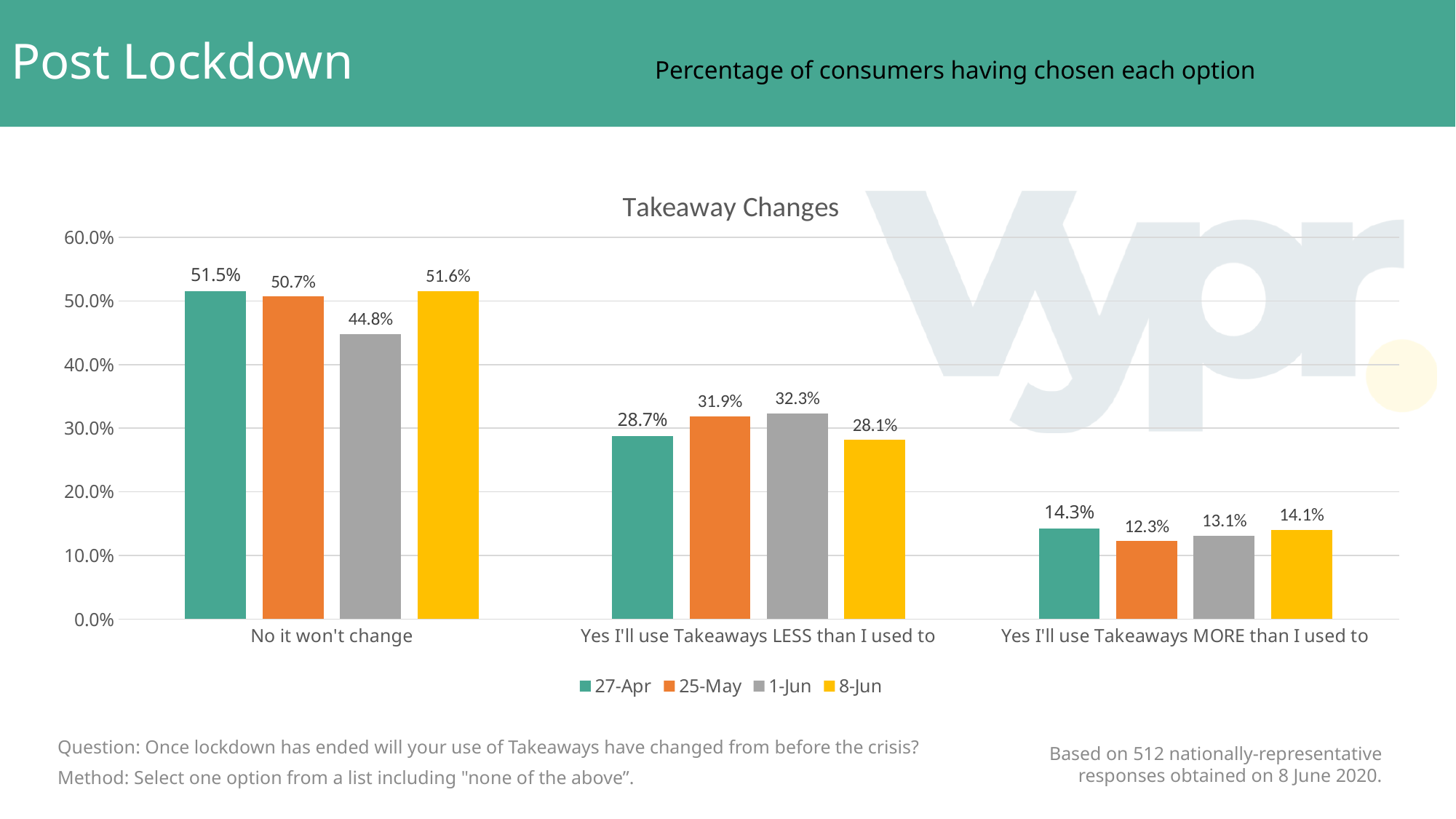
What is the value for 25-May in the 'Yes I'll use Takeaways MORE than I used to' category? 12.3% Which series has the lowest value in the 'No it won't change' category? 1-Jun What kind of chart is shown on the slide? bar chart Which series has the highest value in the 'Yes I'll use Takeaways MORE than I used to' category? 27-Apr How many series does the legend list? 4 What is the title of the chart? Takeaway Changes Which is larger in the 'Yes I'll use Takeaways LESS than I used to' category: the 25-May value or the 8-Jun value? 25-May What is the value for 1-Jun in the 'Yes I'll use Takeaways LESS than I used to' category? 32.3% What is the value for 27-Apr in the 'No it won't change' category? 51.5% What is the difference between the 8-Jun and 1-Jun values in the 'No it won't change' category? 6.8% Is the 8-Jun value for 'Yes I'll use Takeaways MORE than I used to' greater or less than 20.0%? less How many categories are shown on the x axis? 3